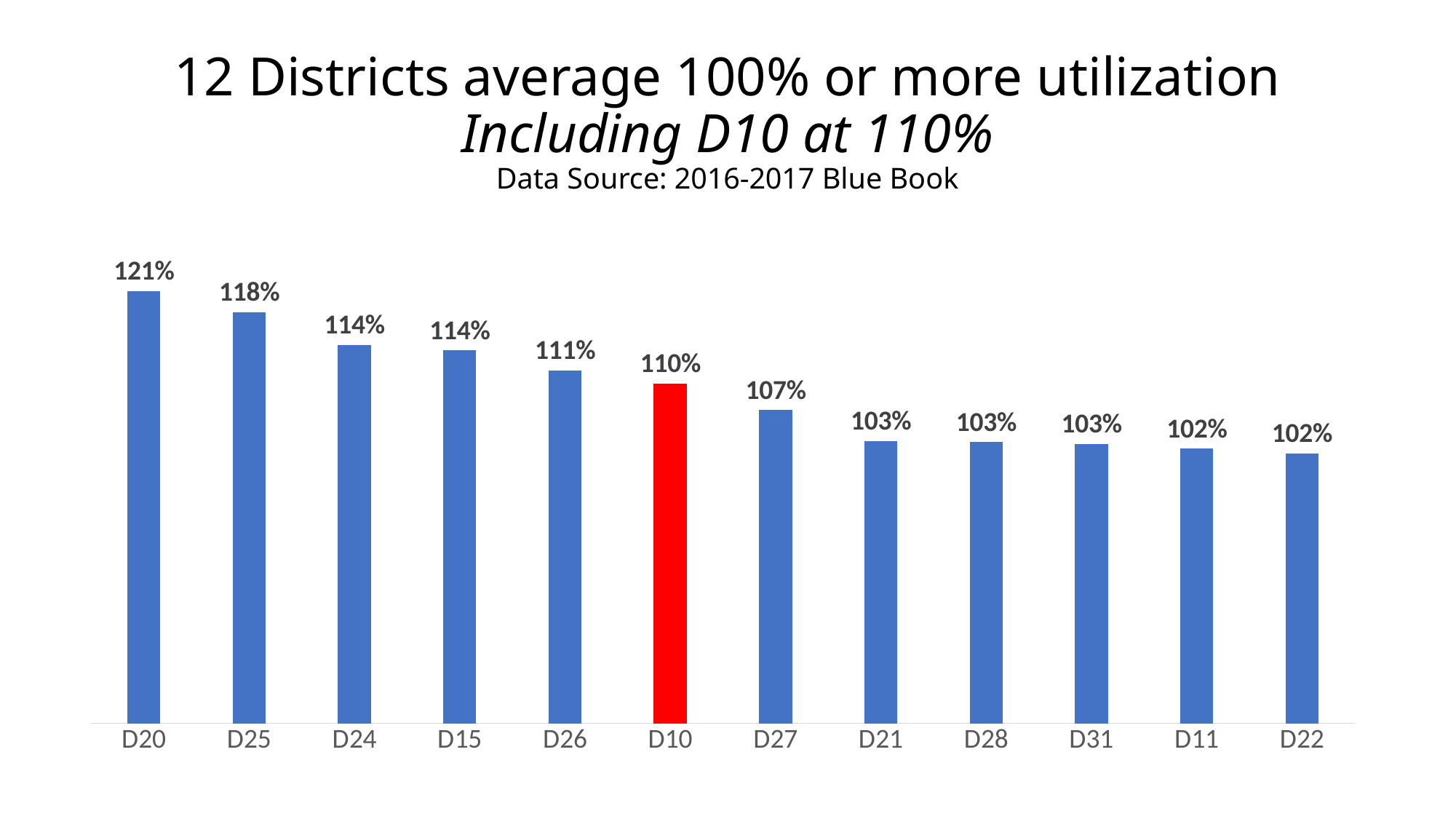
Which has a higher utilization, D24 or D28? D24 What is the utilization value for D27? 107% What is the difference between the utilization of D20 and D10? 11% Do the values rise or fall from left to right along the x axis? Fall Which district's bar is coloured red? D10 Which has a higher utilization, D26 or D21? D26 What is the utilization value for D25? 118% How many districts are shown in the chart? 12 What is the utilization value for D10? 110% What is the difference between the utilization of D25 and D27? 11% What kind of chart is shown on the slide? Bar chart Which district has the highest utilization? D20